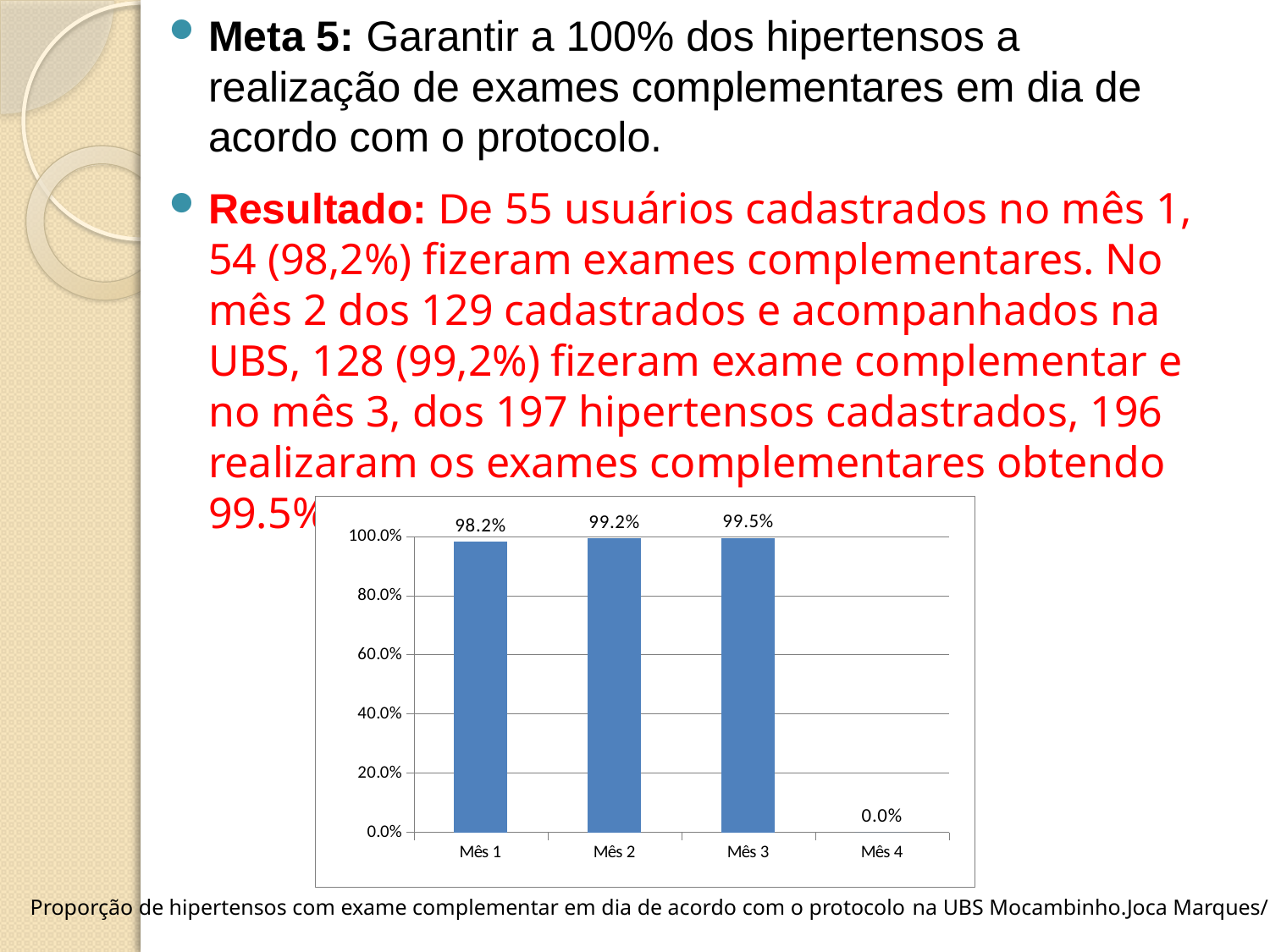
What is the value for Mês 3? 99.5% What is the value for Mês 1? 98.2% What is the difference between the values for Mês 3 and Mês 1? 1.3% Which is larger, the value for Mês 1 or the value for Mês 2? Mês 2 What is the value for Mês 4? 0.0% Do the values rise or fall from Mês 1 to Mês 3? rise Is the value for Mês 2 greater or less than 80.0%? greater What kind of chart is shown? bar chart Which month has the highest value? Mês 3 How many months are shown on the x axis? 4 What is the value for Mês 2? 99.2% Which month has the lowest value? Mês 4